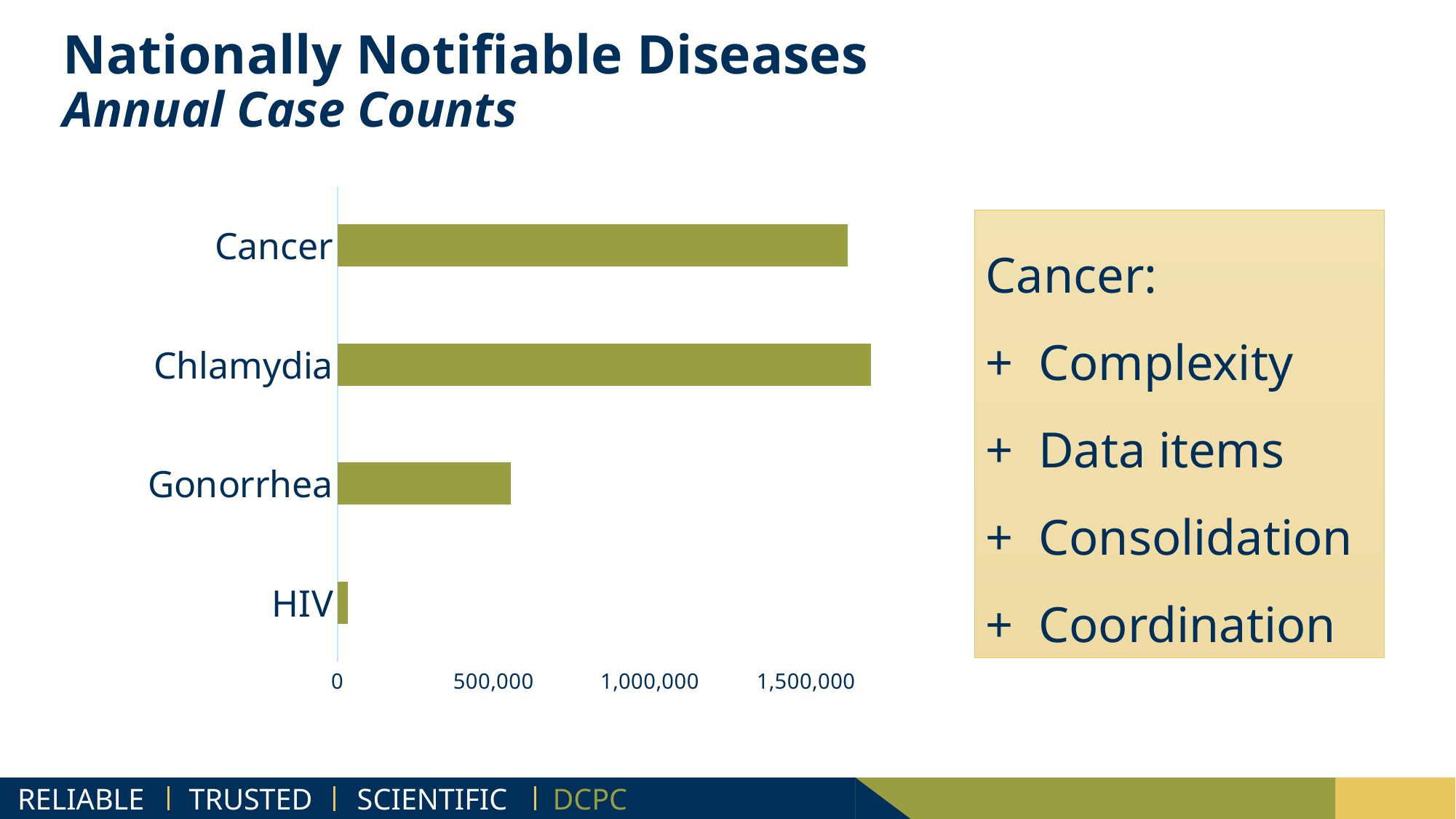
Which has a larger annual case count, Chlamydia or HIV? Chlamydia Is the annual case count for HIV greater or less than 500,000? less Which disease has the lowest annual case count in the chart? HIV How many diseases are plotted in the chart? 4 Is the annual case count for Gonorrhea greater or less than 1,000,000? less Is the annual case count for Cancer greater or less than 1,500,000? greater Which has a larger annual case count, Gonorrhea or HIV? Gonorrhea What kind of chart is shown on the slide? bar chart Which has a larger annual case count, Cancer or Gonorrhea? Cancer Are the bars in the chart drawn horizontally or vertically? horizontally What is the highest value labelled on the chart's horizontal axis? 1,500,000